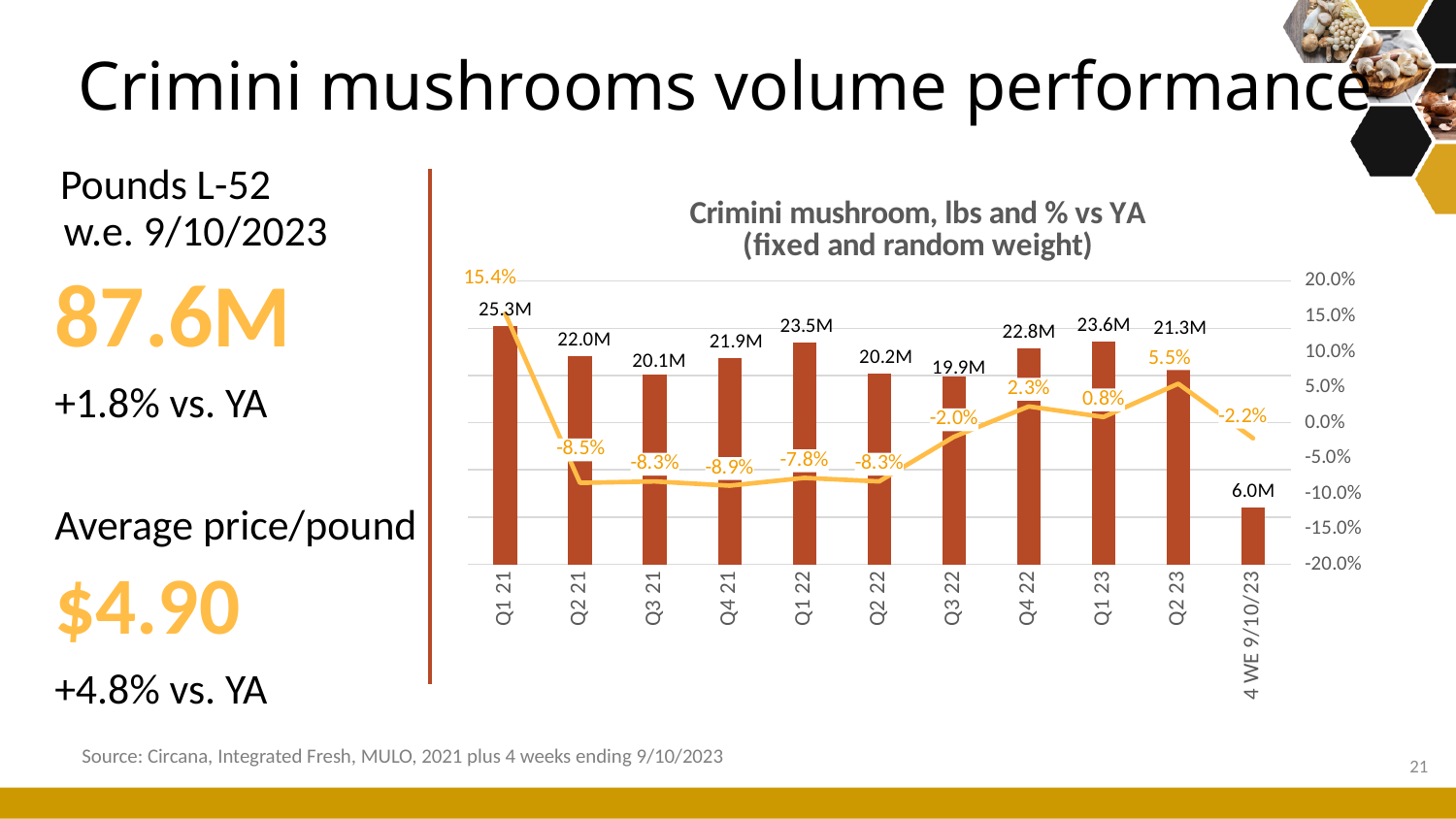
How many periods are shown on the x axis of the chart? 11 Does the % vs YA line rise or fall from Q3 22 to Q4 22? Rise What is the % vs YA value for Q1 22? -7.8% Which period has the lowest % vs YA value? Q4 21 What is the volume in pounds for Q1 21? 25.3M What is the % vs YA value for Q2 23? 5.5% What is the difference in pounds between Q1 23 and Q2 23? 2.3M What is the volume in pounds for the 4 WE 9/10/23 period? 6.0M What kind of chart is used to show the pounds values? Bar chart Which has the larger volume in pounds, Q4 22 or Q3 22? Q4 22 Which quarter has the highest volume in pounds? Q1 21 What is the title of the chart? Crimini mushroom, lbs and % vs YA (fixed and random weight)